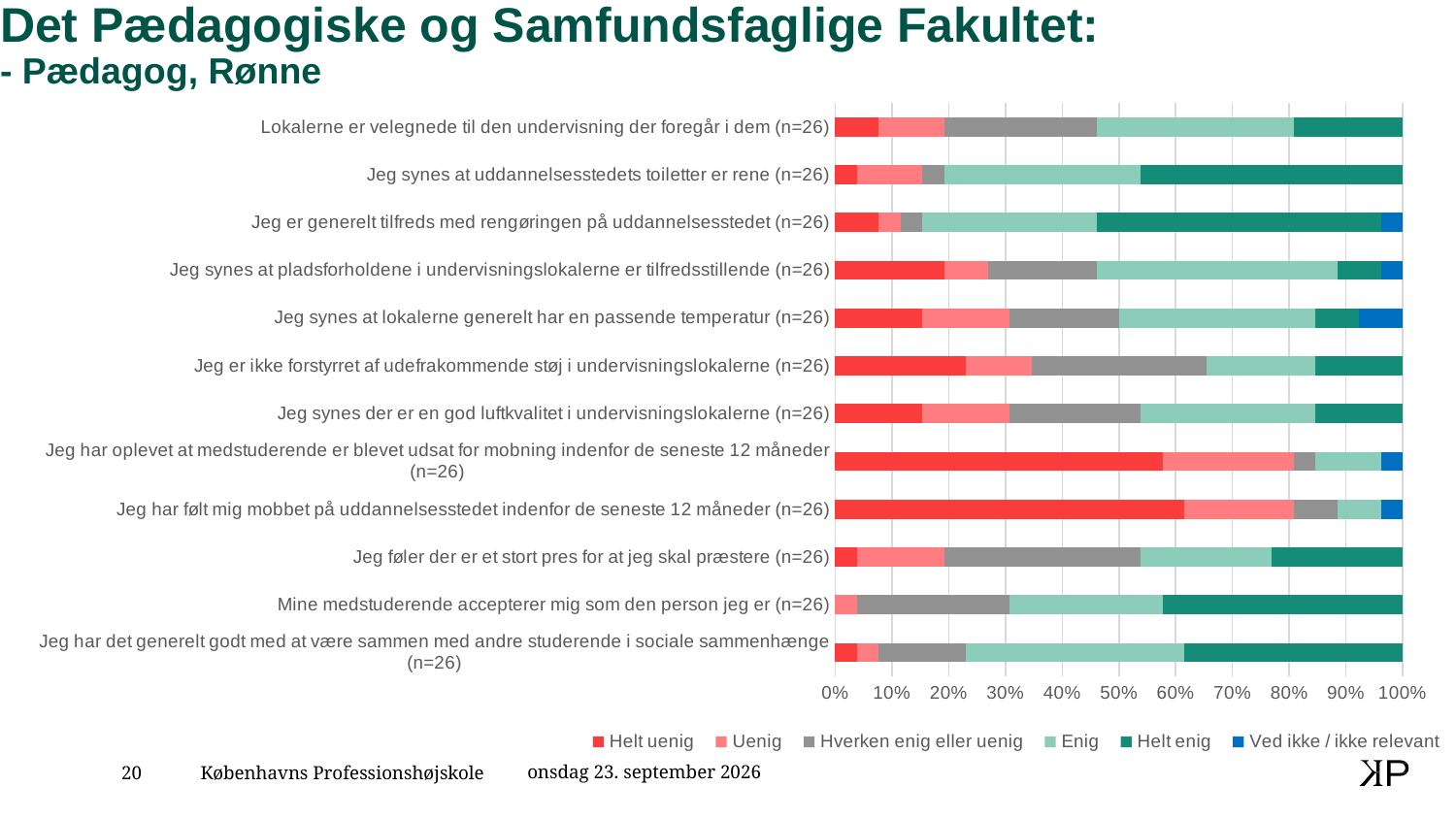
Is the 'Helt uenig' share for 'Jeg har følt mig mobbet på uddannelsesstedet indenfor de seneste 12 måneder (n=26)' greater or less than 50%? greater Is the 'Helt enig' share for 'Jeg synes at uddannelsesstedets toiletter er rene (n=26)' greater or less than 40%? greater Is the 'Helt uenig' share for 'Jeg føler der er et stort pres for at jeg skal præstere (n=26)' greater or less than 10%? less What kind of chart is shown on the slide? Stacked bar chart Which has a larger 'Helt uenig' share: 'Jeg har følt mig mobbet på uddannelsesstedet indenfor de seneste 12 måneder (n=26)' or 'Lokalerne er velegnede til den undervisning der foregår i dem (n=26)'? Jeg har følt mig mobbet på uddannelsesstedet indenfor de seneste 12 måneder (n=26) What is the sample size (n) shown for each statement? 26 Which response category is shown in dark green in the legend? Helt enig How many statements (categories) are plotted in the chart? 12 How many series does the legend list? 6 What do the segments of each stacked bar add up to? 100% Which has a larger 'Helt enig' share: 'Mine medstuderende accepterer mig som den person jeg er (n=26)' or 'Jeg føler der er et stort pres for at jeg skal præstere (n=26)'? Mine medstuderende accepterer mig som den person jeg er (n=26)